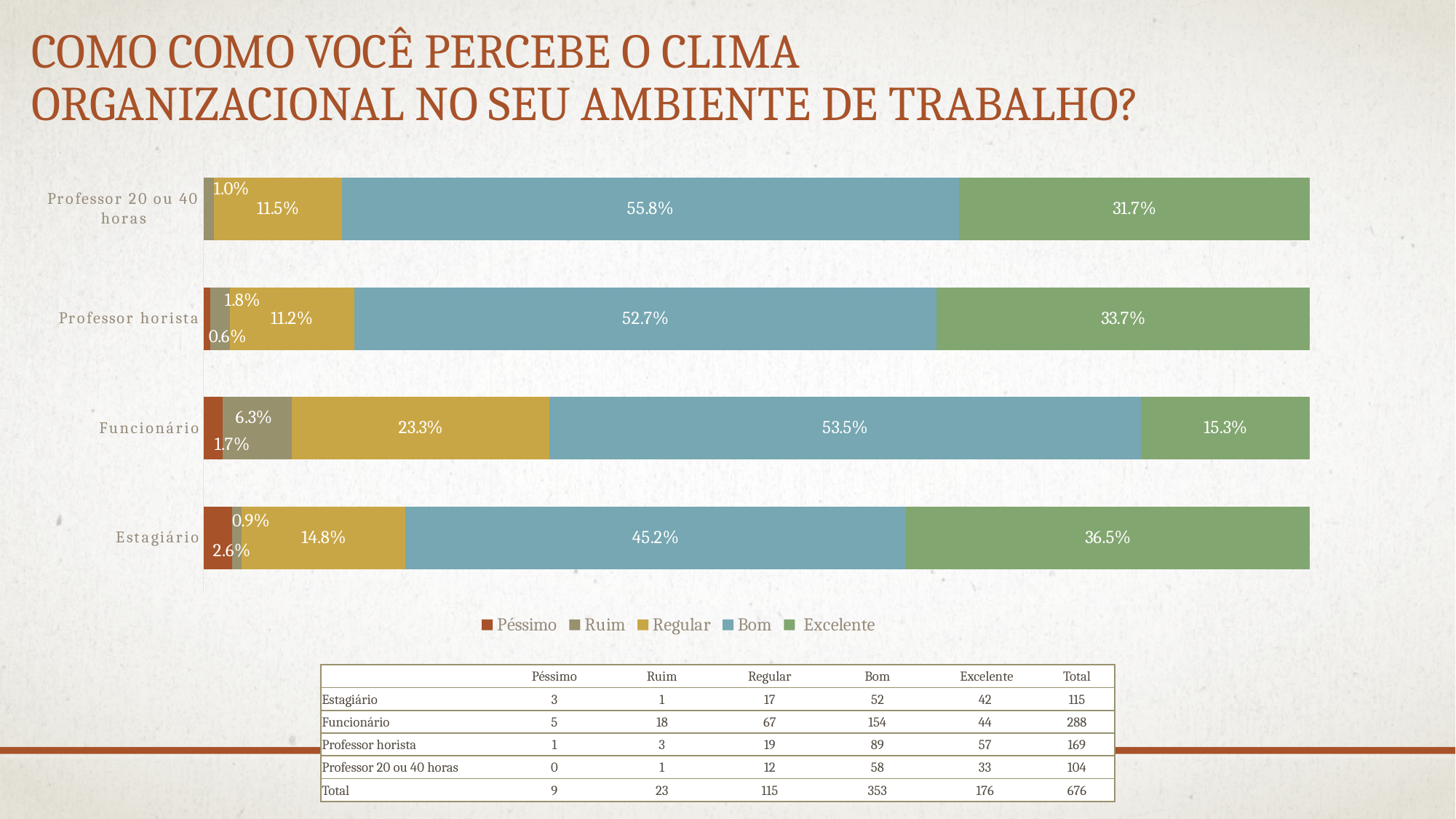
What percentage of Funcionário respondents rated the organizational climate as Regular? 23.3% What is the difference between the Bom values for Funcionário and Estagiário? 8.3 percentage points How many categories are shown on the chart? 4 How many series does the legend list? 5 What is the Bom value for Professor horista? 52.7% Which series is shown in green in the legend? Excelente Which category has the lowest Excelente percentage? Funcionário Which is larger: the Regular value for Funcionário or the Regular value for Estagiário? Funcionário What is the Excelente value for Estagiário? 36.5% Which category has the highest Bom percentage? Professor 20 ou 40 horas What is the Péssimo value for Funcionário? 1.7% What kind of chart is shown on the slide? Stacked bar chart